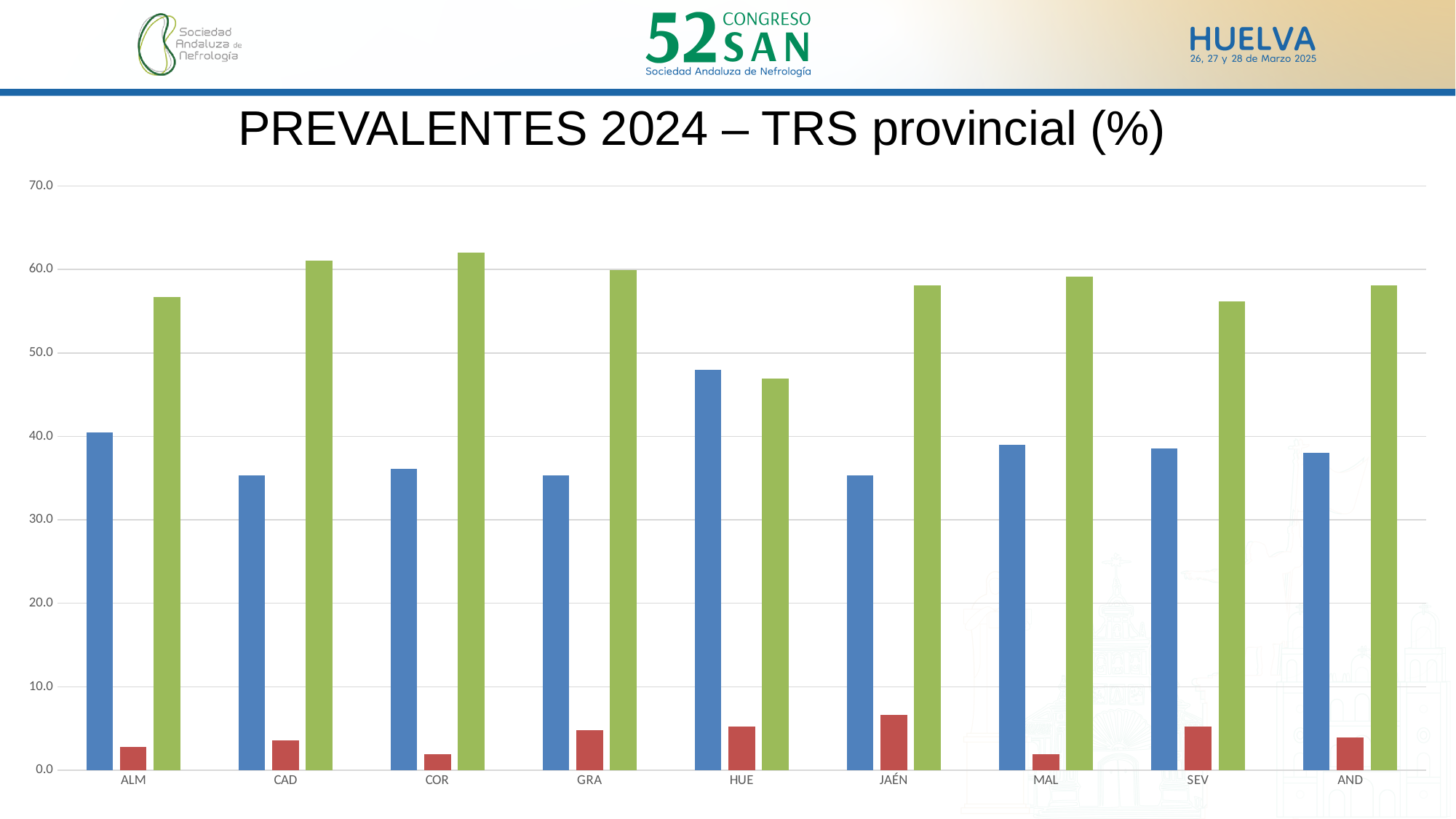
Which category has the lowest green bar? HUE What is the title of the chart? PREVALENTES 2024 – TRS provincial (%) What kind of chart is shown on the slide? bar chart Is the value of the green bar for COR greater or less than 60.0? greater Which category has the highest red bar? JAÉN Is the value of the green bar for ALM greater or less than 60.0? less Is the value of the blue bar for CAD greater or less than 30.0? greater Which category has the highest blue bar? HUE How many bars are plotted for each category on the chart? 3 How many categories are shown on the x axis of the chart? 9 Which is larger, the blue bar for HUE or the blue bar for ALM? HUE